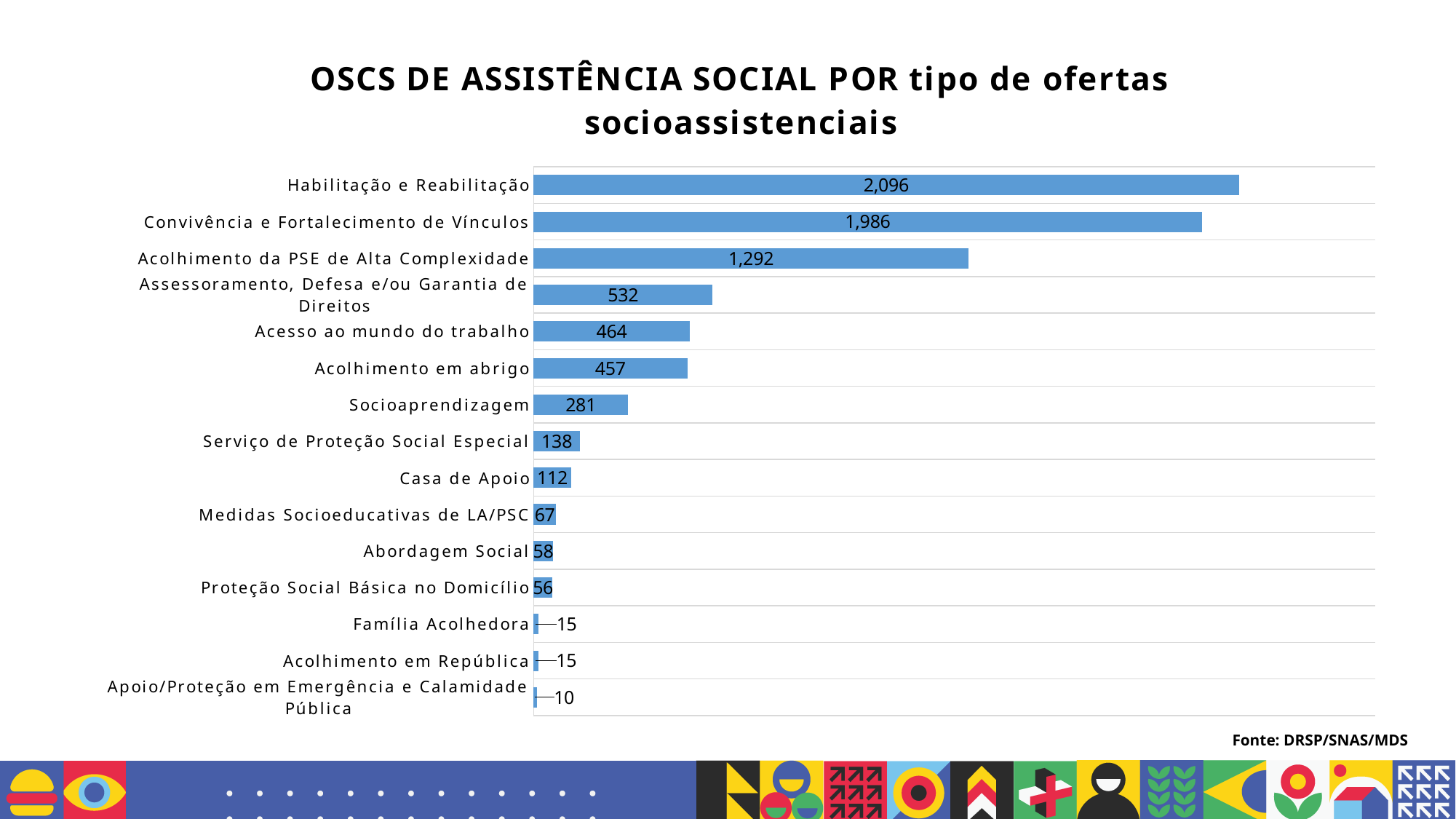
What is the value for Acolhimento da PSE de Alta Complexidade? 1,292 What is the value for Habilitação e Reabilitação? 2,096 Which category has the highest value? Habilitação e Reabilitação What is the source cited for the chart? DRSP/SNAS/MDS What kind of chart is shown on the slide? Bar chart How many categories are shown in the chart? 15 Which category has the lowest value? Apoio/Proteção em Emergência e Calamidade Pública What is the value for Socioaprendizagem? 281 What is the difference between Acesso ao mundo do trabalho and Acolhimento em abrigo? 7 Which is larger, Assessoramento, Defesa e/ou Garantia de Direitos or Acesso ao mundo do trabalho? Assessoramento, Defesa e/ou Garantia de Direitos What is the difference between Habilitação e Reabilitação and Convivência e Fortalecimento de Vínculos? 110 What is the value for Casa de Apoio? 112